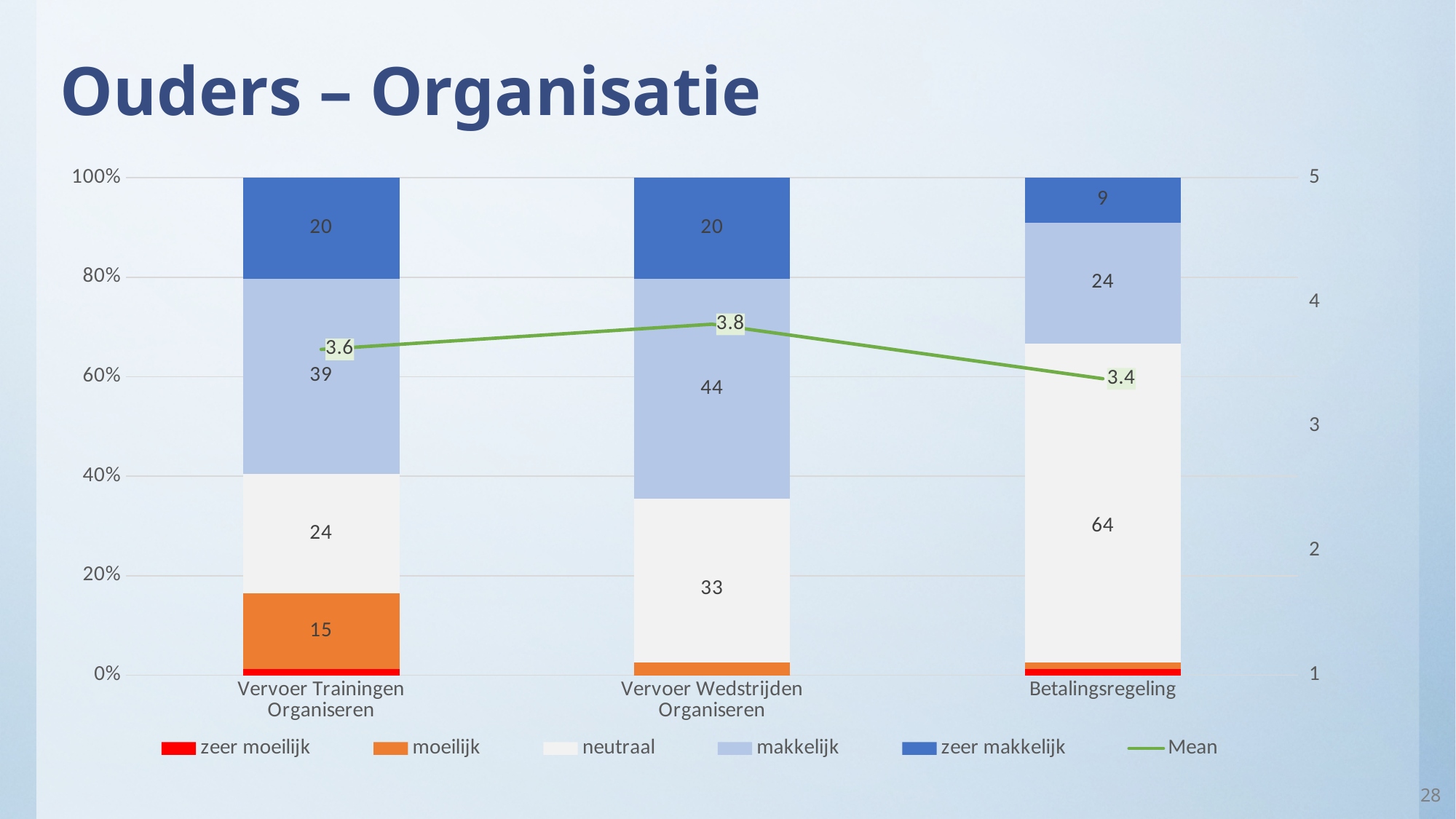
Which category has the highest Mean value? Vervoer Wedstrijden Organiseren What kind of chart is shown on the slide? Stacked bar chart with a line How many categories are shown on the x axis? 3 What is the Mean value for Vervoer Wedstrijden Organiseren? 3.8 What is the 'moeilijk' value for Vervoer Trainingen Organiseren? 15 Which category has the lowest 'zeer makkelijk' value? Betalingsregeling What is the 'makkelijk' value for Vervoer Trainingen Organiseren? 39 What is the title of the slide? Ouders – Organisatie What is the 'neutraal' value for Betalingsregeling? 64 What is the difference between the 'neutraal' values for Betalingsregeling and Vervoer Wedstrijden Organiseren? 31 Which is larger: the 'makkelijk' value for Vervoer Wedstrijden Organiseren or for Betalingsregeling? Vervoer Wedstrijden Organiseren How many series does the legend list? 6